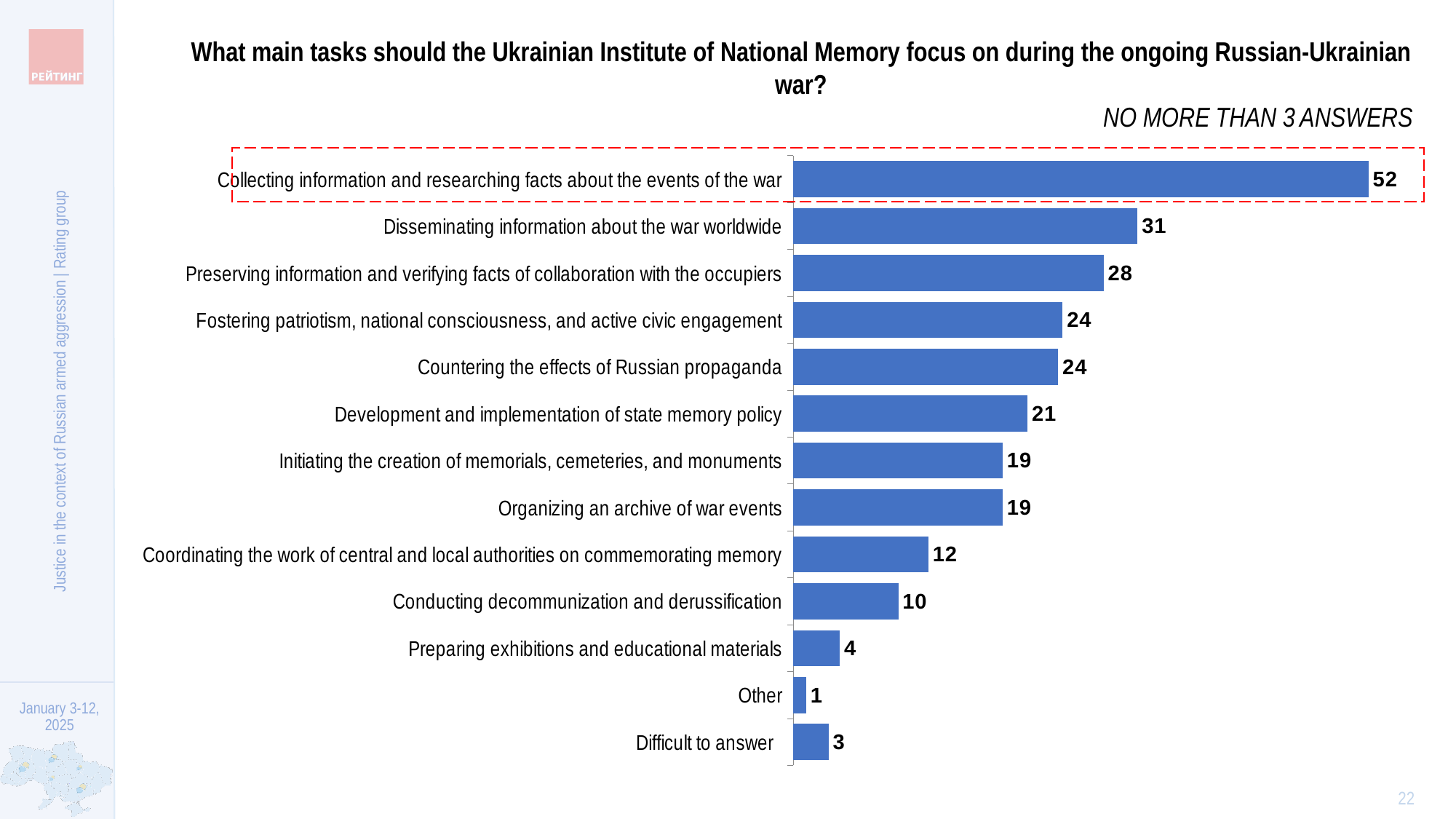
What is the value for "Preparing exhibitions and educational materials"? 4 What is the difference between the values for "Collecting information and researching facts about the events of the war" and "Disseminating information about the war worldwide"? 21 Which category has the highest value? Collecting information and researching facts about the events of the war How many categories are shown in the chart? 13 What is the value for "Collecting information and researching facts about the events of the war"? 52 What is the value for "Conducting decommunization and derussification"? 10 Which is larger: the value for "Preserving information and verifying facts of collaboration with the occupiers" or the value for "Development and implementation of state memory policy"? Preserving information and verifying facts of collaboration with the occupiers Which category has the lowest value? Other What kind of chart is shown on the slide? Bar chart What is the value for "Disseminating information about the war worldwide"? 31 What is the value for "Difficult to answer"? 3 What note appears above the chart about the number of answers allowed? NO MORE THAN 3 ANSWERS